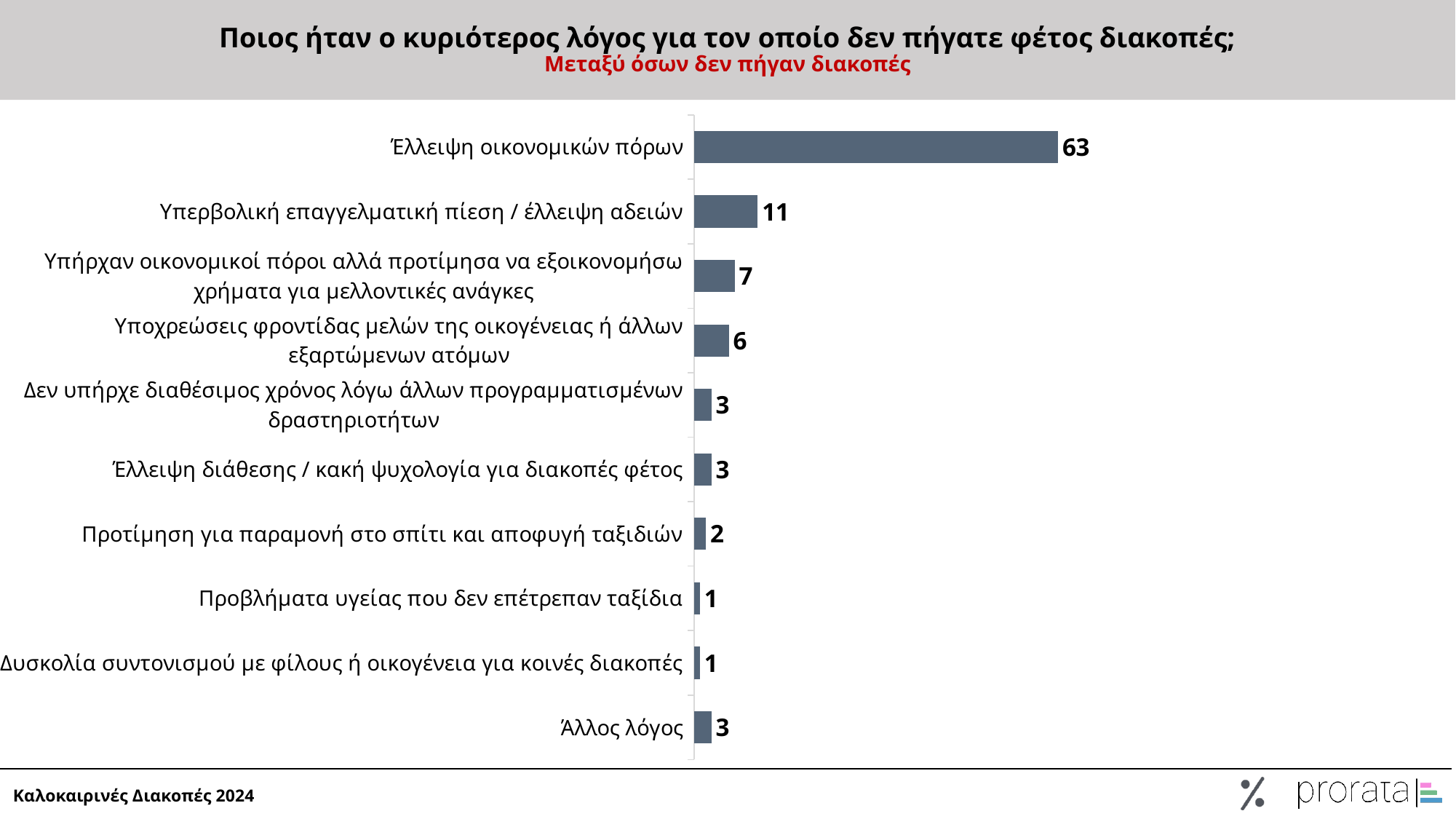
What is the value for 'Υπερβολική επαγγελματική πίεση / έλλειψη αδειών'? 11 What is the value for 'Υποχρεώσεις φροντίδας μελών της οικογένειας ή άλλων εξαρτώμενων ατόμων'? 6 Which is larger: the value for 'Υπήρχαν οικονομικοί πόροι αλλά προτίμησα να εξοικονομήσω χρήματα για μελλοντικές ανάγκες' or for 'Προτίμηση για παραμονή στο σπίτι και αποφυγή ταξιδιών'? Υπήρχαν οικονομικοί πόροι αλλά προτίμησα να εξοικονομήσω χρήματα για μελλοντικές ανάγκες What is the value for 'Έλλειψη οικονομικών πόρων'? 63 What is the difference between the values for 'Υπερβολική επαγγελματική πίεση / έλλειψη αδειών' and 'Υποχρεώσεις φροντίδας μελών της οικογένειας ή άλλων εξαρτώμενων ατόμων'? 5 What is the red subtitle text under the chart title? Μεταξύ όσων δεν πήγαν διακοπές How many categories are shown in the chart? 10 What kind of chart is shown on the slide? Bar chart What is the value for 'Προβλήματα υγείας που δεν επέτρεπαν ταξίδια'? 1 What is the difference between the values for 'Έλλειψη οικονομικών πόρων' and 'Υπερβολική επαγγελματική πίεση / έλλειψη αδειών'? 52 Which category has the highest value? Έλλειψη οικονομικών πόρων What is the value for 'Άλλος λόγος'? 3